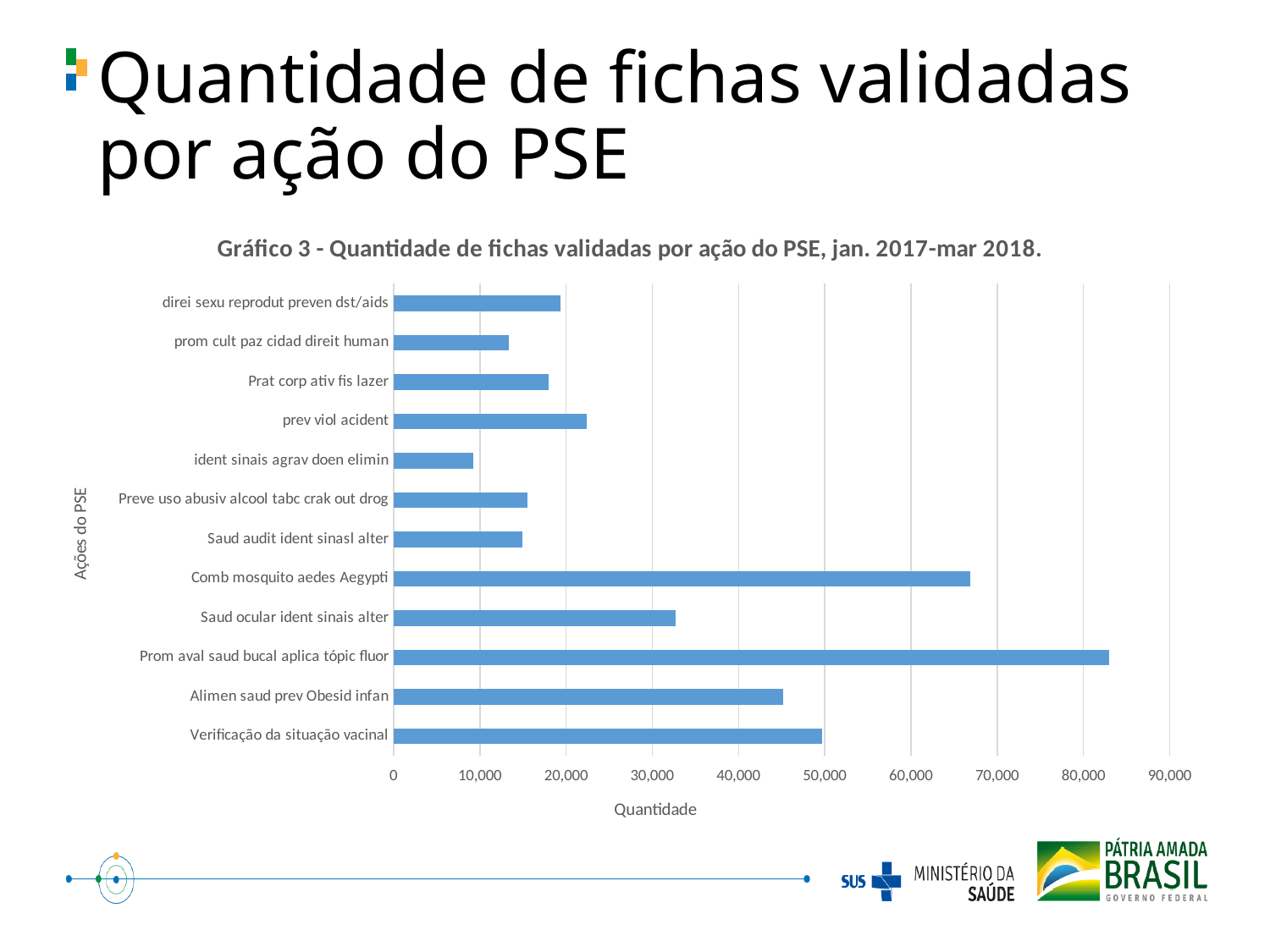
Which PSE action has the highest number of validated forms? Prom aval saud bucal aplica tópic fluor Is the value for Prom aval saud bucal aplica tópic fluor greater or less than 80,000? greater Is the value for Comb mosquito aedes Aegypti greater or less than 60,000? greater Which has a larger value: Comb mosquito aedes Aegypti or Saud ocular ident sinais alter? Comb mosquito aedes Aegypti Is the value for prev viol acident greater or less than 20,000? greater What is the label of the horizontal axis of the chart? Quantidade What kind of chart is shown on the slide? Bar chart How many PSE actions (categories) are plotted in the chart? 12 Which PSE action has the lowest number of validated forms? ident sinais agrav doen elimin Which has a larger value: Prat corp ativ fis lazer or prom cult paz cidad direit human? Prat corp ativ fis lazer